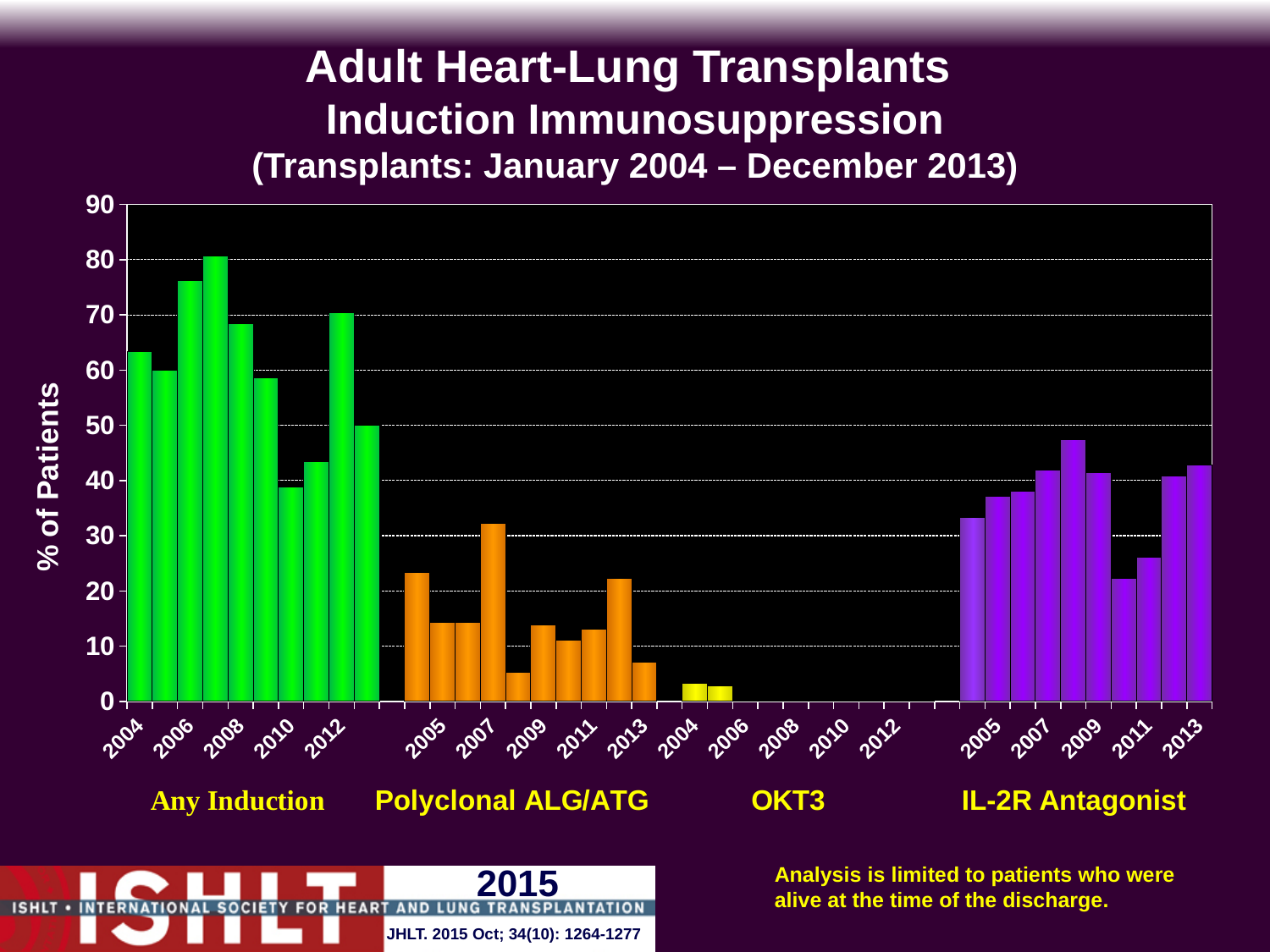
In the Any Induction group, which year has the highest percentage of patients? 2007 Which induction category has the lowest bars overall? OKT3 What is the label on the y axis? % of Patients In the Polyclonal ALG/ATG group, which year has the highest percentage of patients? 2007 Is the IL-2R Antagonist value for 2010 greater or less than 30? less In the IL-2R Antagonist group, which year has the highest percentage of patients? 2008 In the Any Induction group, which year has the lowest percentage of patients? 2010 Is the Any Induction value for 2006 greater or less than 70? greater In the Polyclonal ALG/ATG group, which year has the lowest percentage of patients? 2008 What kind of chart is shown on the slide? bar chart How many induction categories (groups of bars) are shown along the x axis? 4 Is the Polyclonal ALG/ATG value for 2007 greater or less than 30? greater